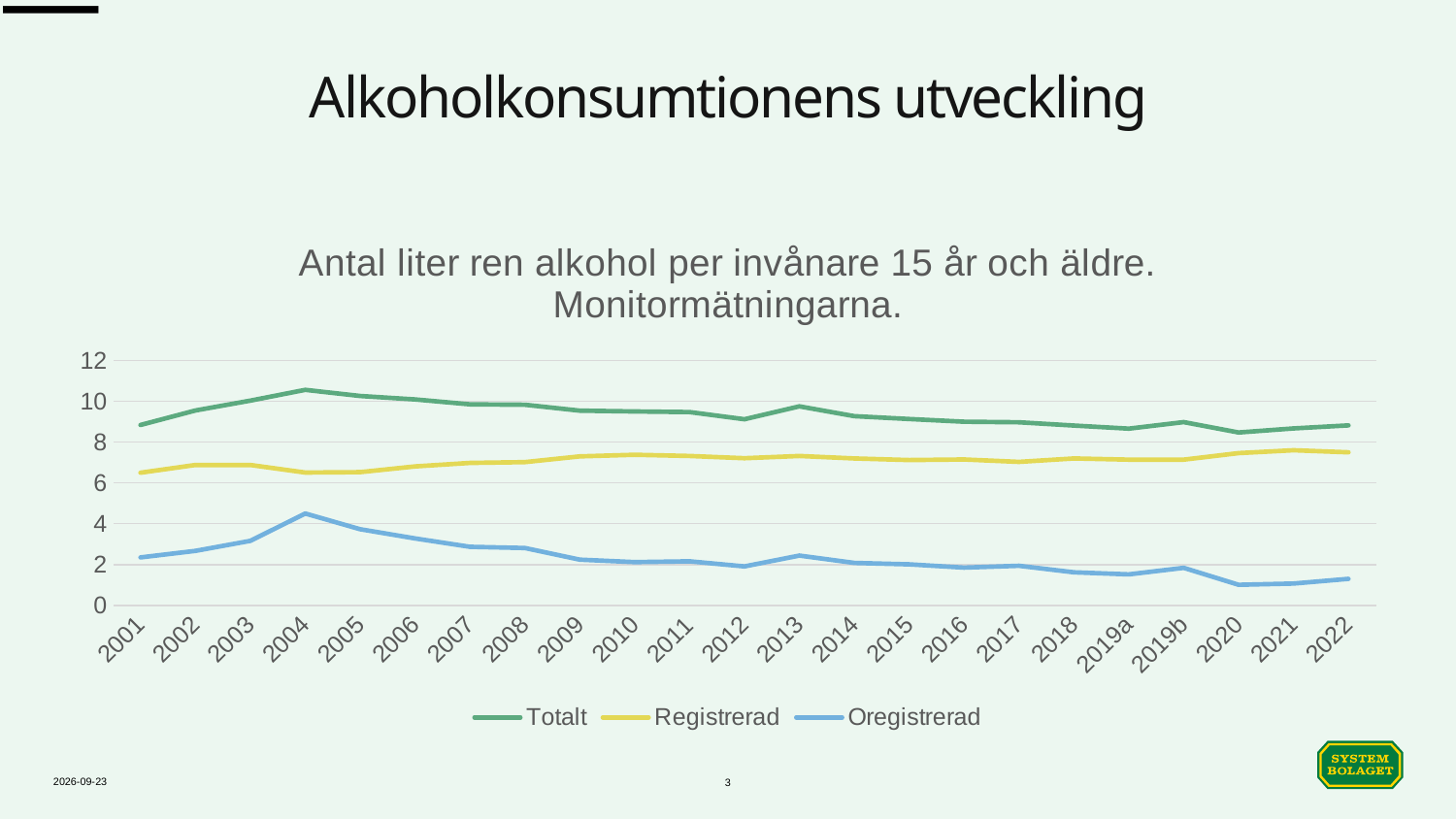
How many points are plotted along the x axis for each series? 23 Which is larger for Oregistrerad, the value in 2004 or the value in 2022? 2004 What kind of chart is shown on the slide? line chart In which year does the Totalt series reach its highest value? 2004 Is the value for Registrerad in 2022 greater or less than 8? less Which is larger in 2001, Totalt or Registrerad? Totalt Is the value for Oregistrerad in 2020 greater or less than 2? less Is the value for Totalt in 2004 greater or less than 10? greater Does the Oregistrerad series generally rise or fall from 2004 to 2022? fall How many series does the legend list? 3 Which series is drawn in blue? Oregistrerad In which year does the Oregistrerad series reach its highest value? 2004